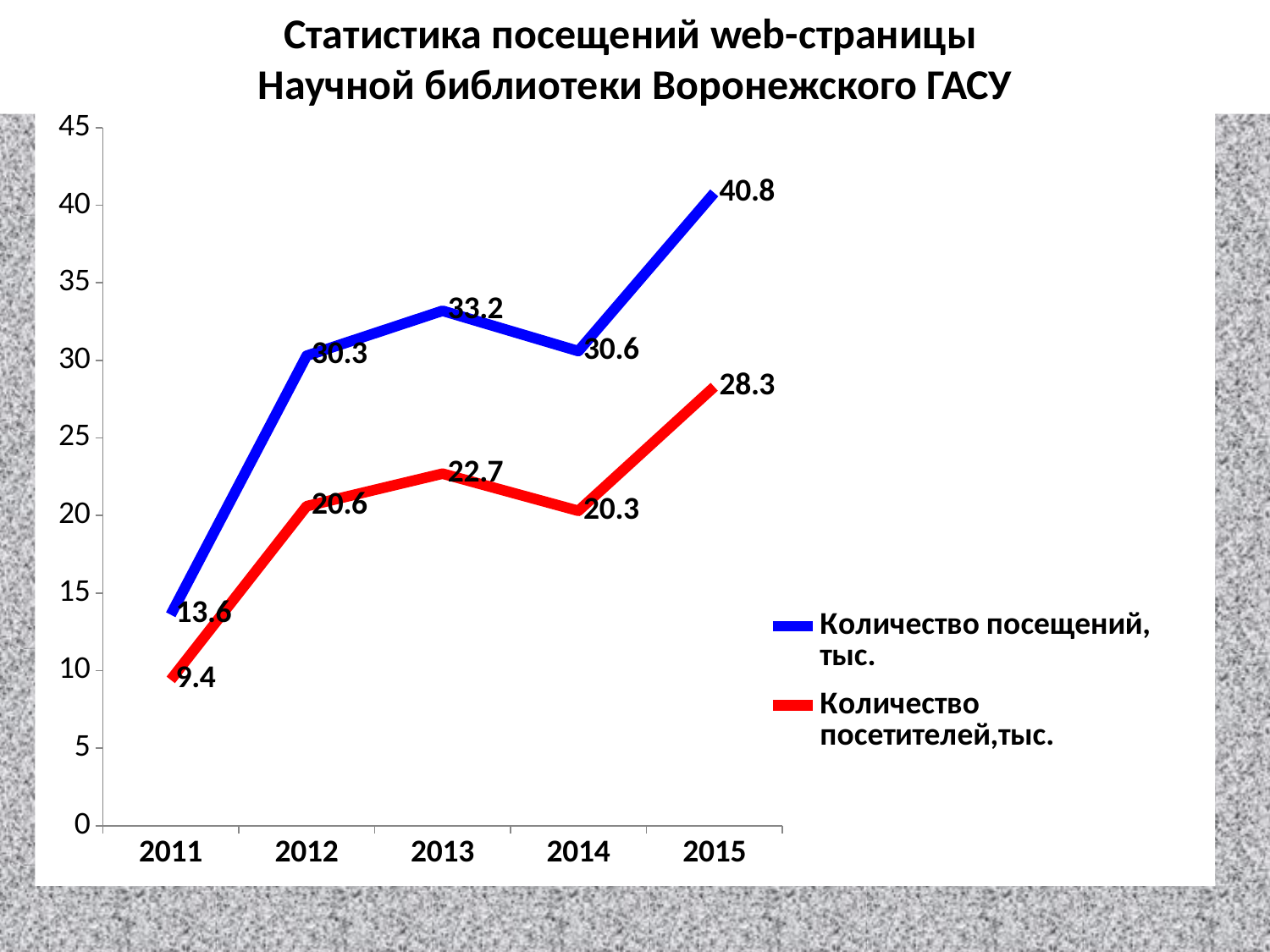
What is the difference between "Количество посещений, тыс." and "Количество посетителей,тыс." in 2015? 12.5 What is the value of "Количество посетителей,тыс." in 2014? 20.3 In which year is "Количество посетителей,тыс." highest? 2015 What kind of chart is shown on the slide? Line chart How many series does the legend list? 2 What is the value of "Количество посещений, тыс." in 2015? 40.8 In which year is "Количество посещений, тыс." lowest? 2011 What colour is the line for "Количество посетителей,тыс."? Red Which is larger: "Количество посещений, тыс." in 2012 or in 2014? 2014 How many years are shown on the x axis? 5 What is the value of "Количество посетителей,тыс." in 2011? 9.4 What is the value of "Количество посещений, тыс." in 2013? 33.2